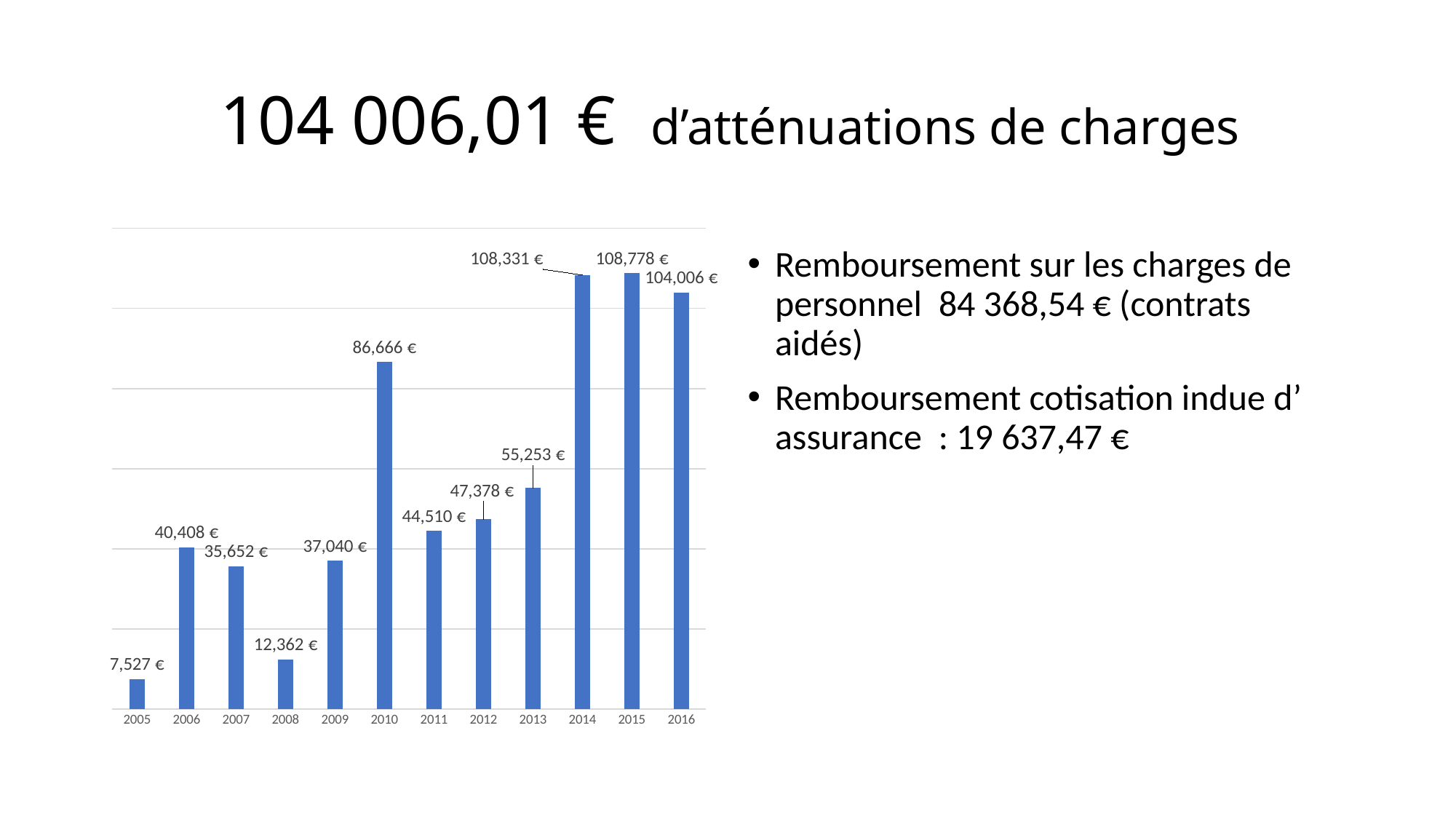
What kind of chart is shown? Bar chart What is the difference between the values for 2015 and 2016? 4,772 € Do the values rise or fall from 2011 to 2014? Rise What is the difference between the values for 2010 and 2009? 49,626 € Which year has the lowest value? 2005 What is the value for 2010? 86,666 € What is the value for 2013? 55,253 € Which year has the highest value? 2015 Which is larger, the value for 2007 or the value for 2009? 2009 What is the value for 2005? 7,527 € What is the value for 2016? 104,006 € How many years are shown on the x axis? 12